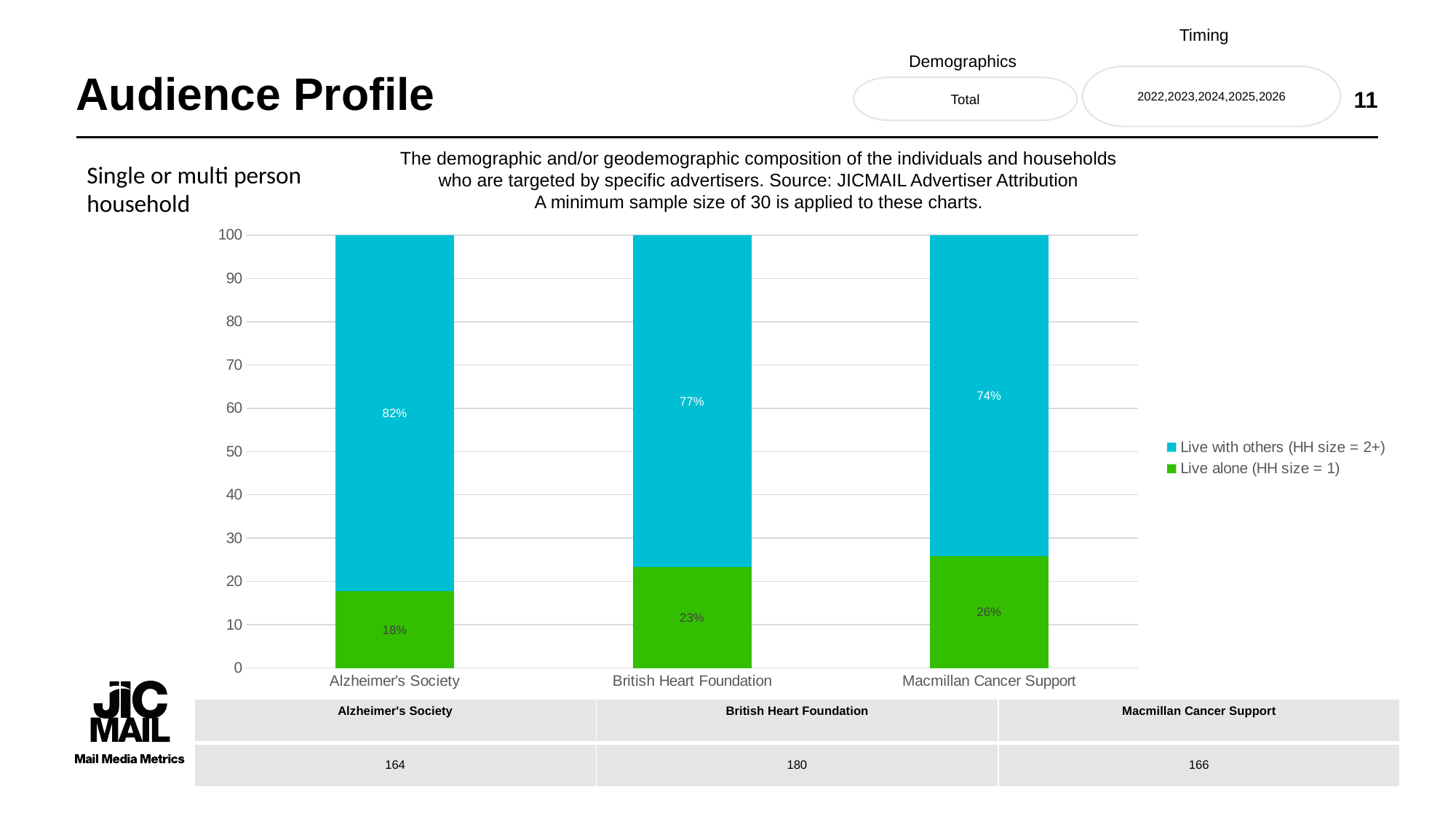
Is the 'Live alone' value for Macmillan Cancer Support greater or less than 20? greater Which advertiser has the highest share of people who live alone (HH size = 1)? Macmillan Cancer Support What percentage of the Macmillan Cancer Support audience lives alone (HH size = 1)? 26% What percentage of the British Heart Foundation audience lives with others (HH size = 2+)? 77% What is the difference in percentage points between the 'Live with others' share for Alzheimer's Society and Macmillan Cancer Support? 8 What percentage of the Alzheimer's Society audience lives alone (HH size = 1)? 18% What is the total of the stacked bar for British Heart Foundation? 100% How many advertisers are shown on the x axis of the chart? 3 Which advertiser has the lowest share of people who live with others (HH size = 2+)? Macmillan Cancer Support How many series does the chart legend list? 2 Which is larger: the 'Live alone' share for British Heart Foundation or for Alzheimer's Society? British Heart Foundation What kind of chart is shown on the slide? Stacked bar chart